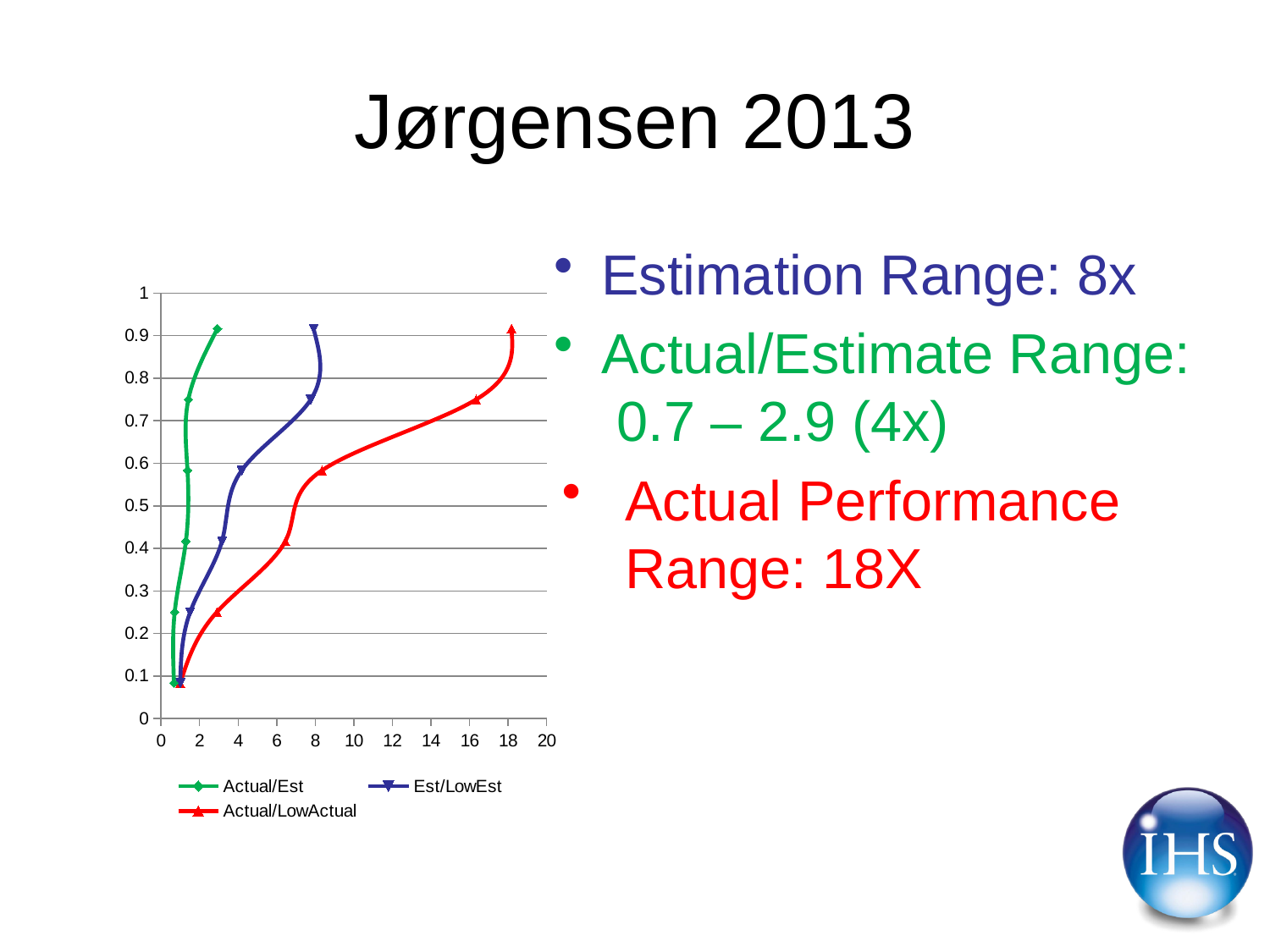
At the topmost point (around 0.9 on the y axis), is the x value of the Actual/LowActual series greater or less than 16? greater What is the maximum value shown on the x axis? 20 How many series does the chart legend list? 3 How many marked data points does the Actual/Est series have? 6 At the topmost point (around 0.9 on the y axis), is the x value of the Actual/Est series greater or less than 4? less At the topmost point (around 0.9 on the y axis), is the x value of the Est/LowEst series greater or less than 6? greater Do the x values of the Actual/LowActual series rise or fall as the y value increases? rise What kind of chart is shown on the slide? line chart What colour is the Est/LowEst series drawn in? blue Which series stays closest to the left (smallest x values) across the chart? Actual/Est Which series reaches the largest value on the x axis? Actual/LowActual At the topmost point, which series has the larger x value: Actual/LowActual or Actual/Est? Actual/LowActual